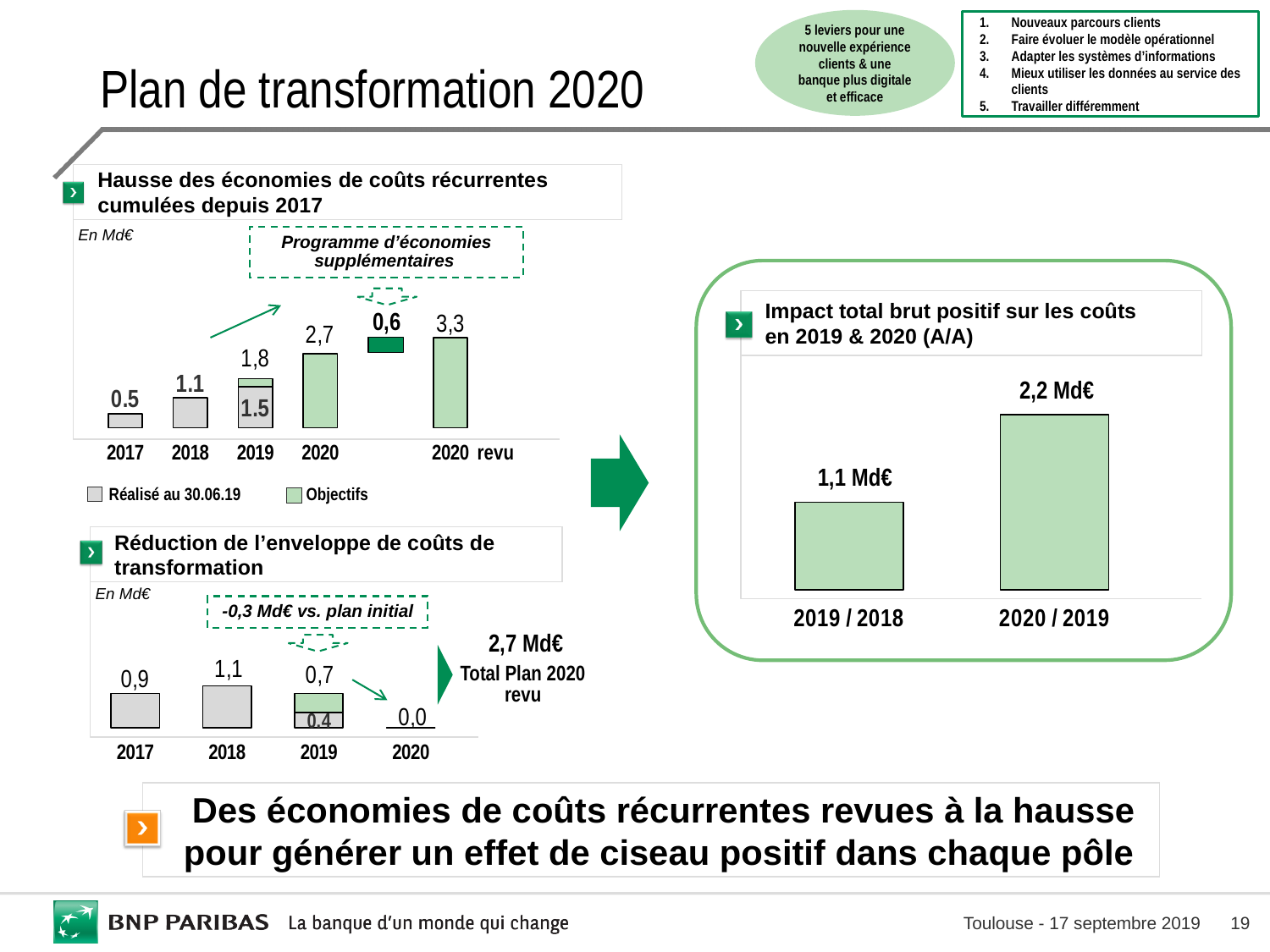
In the chart 'Hausse des économies de coûts récurrentes cumulées depuis 2017', what is the value for 2020 revu? 3,3 In the chart 'Réduction de l'enveloppe de coûts de transformation', what is the value for 2018? 1,1 In the chart 'Impact total brut positif sur les coûts en 2019 & 2020 (A/A)', how many bars are shown? 2 In the chart 'Hausse des économies de coûts récurrentes cumulées depuis 2017', how many entries does the legend list? 2 In the chart 'Hausse des économies de coûts récurrentes cumulées depuis 2017', which category has the highest value? 2020 revu In the chart 'Impact total brut positif sur les coûts en 2019 & 2020 (A/A)', what is the difference between the 2020 / 2019 and 2019 / 2018 values? 1,1 Md€ In the chart 'Hausse des économies de coûts récurrentes cumulées depuis 2017', what is the value for 2017? 0.5 In the chart 'Impact total brut positif sur les coûts en 2019 & 2020 (A/A)', what is the value for 2019 / 2018? 1,1 Md€ In the chart 'Réduction de l'enveloppe de coûts de transformation', which year has the lowest value? 2020 In the chart 'Hausse des économies de coûts récurrentes cumulées depuis 2017', what is the value of the 'Programme d'économies supplémentaires' segment? 0,6 In the chart 'Impact total brut positif sur les coûts en 2019 & 2020 (A/A)', what is the value for 2020 / 2019? 2,2 Md€ What kind of chart is 'Réduction de l'enveloppe de coûts de transformation'? Bar chart